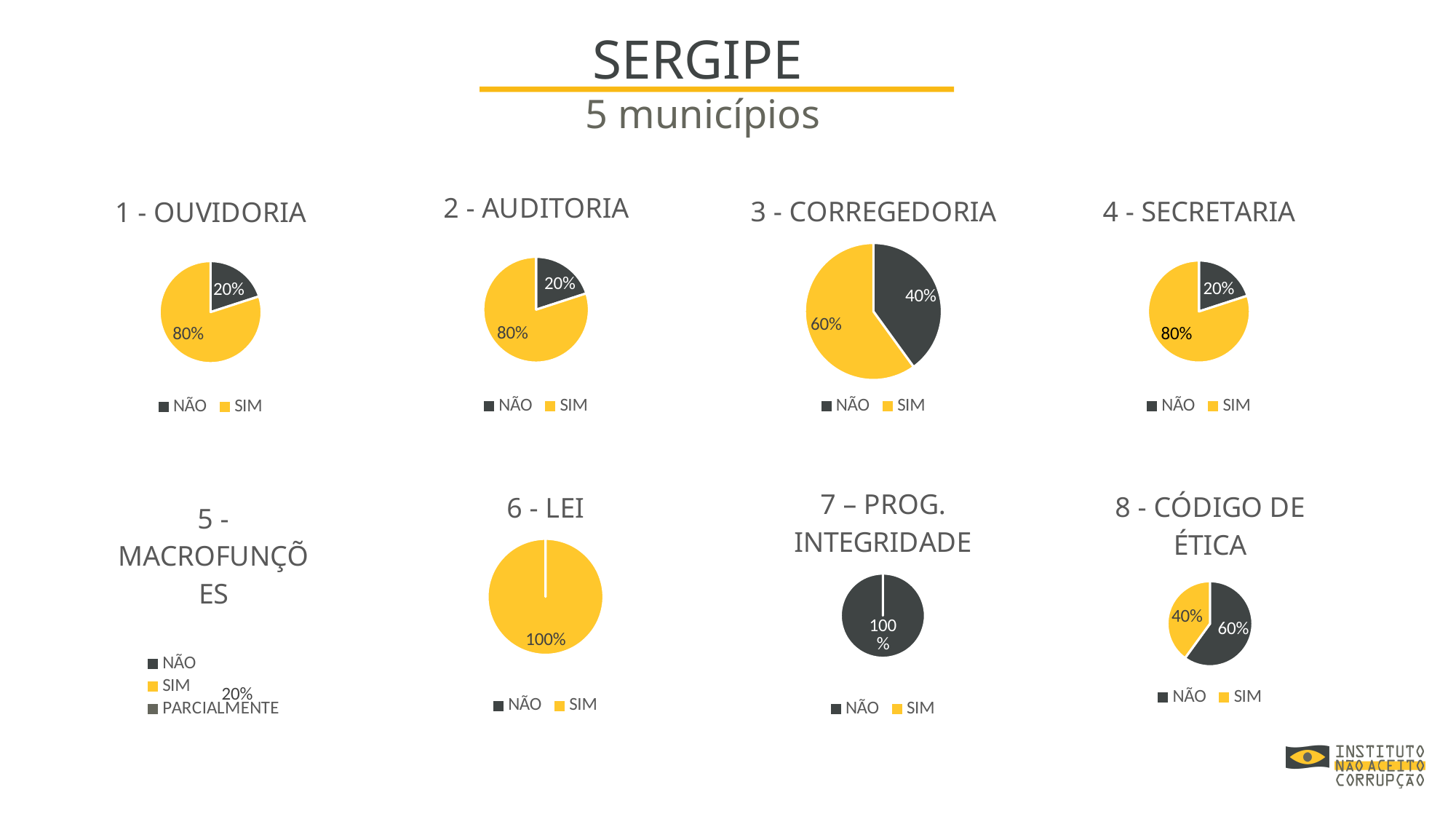
In the "7 – PROG. INTEGRIDADE" chart, what share is NÃO? 100% How many entries does the legend of the "5 - MACROFUNÇÕES" chart list? 3 In the "2 - AUDITORIA" chart, which colour represents SIM? Yellow In the "8 - CÓDIGO DE ÉTICA" chart, what is the difference between the NÃO and SIM shares? 20% What kind of chart is "2 - AUDITORIA"? Pie chart In the "8 - CÓDIGO DE ÉTICA" chart, what share is NÃO? 60% In the "6 - LEI" chart, what share is SIM? 100% In the "3 - CORREGEDORIA" chart, which slice is larger, SIM or NÃO? SIM